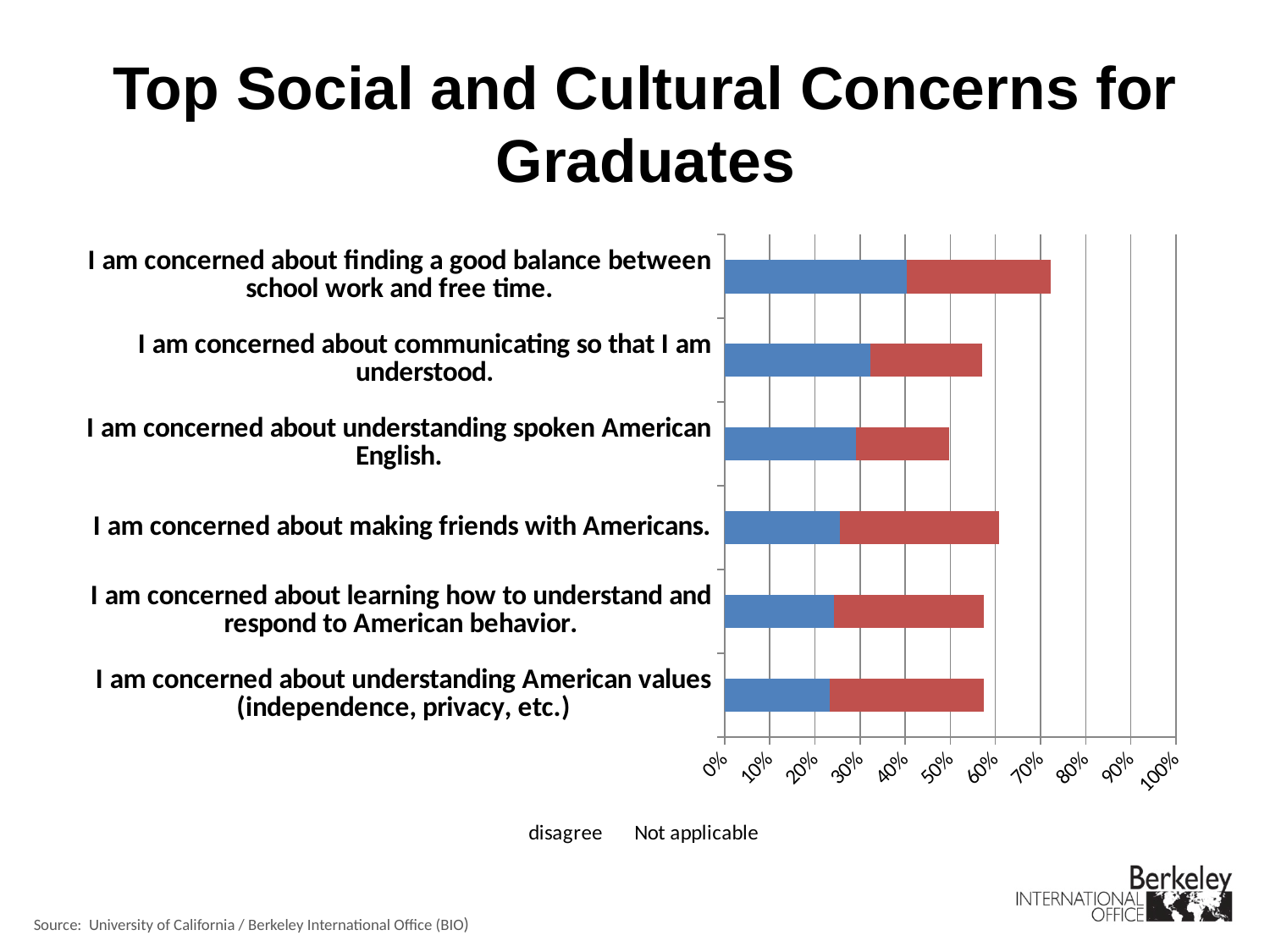
What are the two entries listed in the chart's legend? disagree, Not applicable Which concern statement has the shortest total bar? I am concerned about understanding spoken American English. Is the total bar for "I am concerned about finding a good balance between school work and free time." greater or less than 60%? greater Is the total bar for "I am concerned about understanding spoken American English." greater or less than 60%? less Is the blue segment for "I am concerned about understanding American values (independence, privacy, etc.)" greater or less than 30%? less How many concern statements (categories) are plotted in the chart? 6 Which has the larger blue segment: "I am concerned about finding a good balance between school work and free time." or "I am concerned about communicating so that I am understood."? I am concerned about finding a good balance between school work and free time. What kind of chart is shown on the slide? bar chart Which concern statement has the longest total bar? I am concerned about finding a good balance between school work and free time. How many series does the chart's legend list? 2